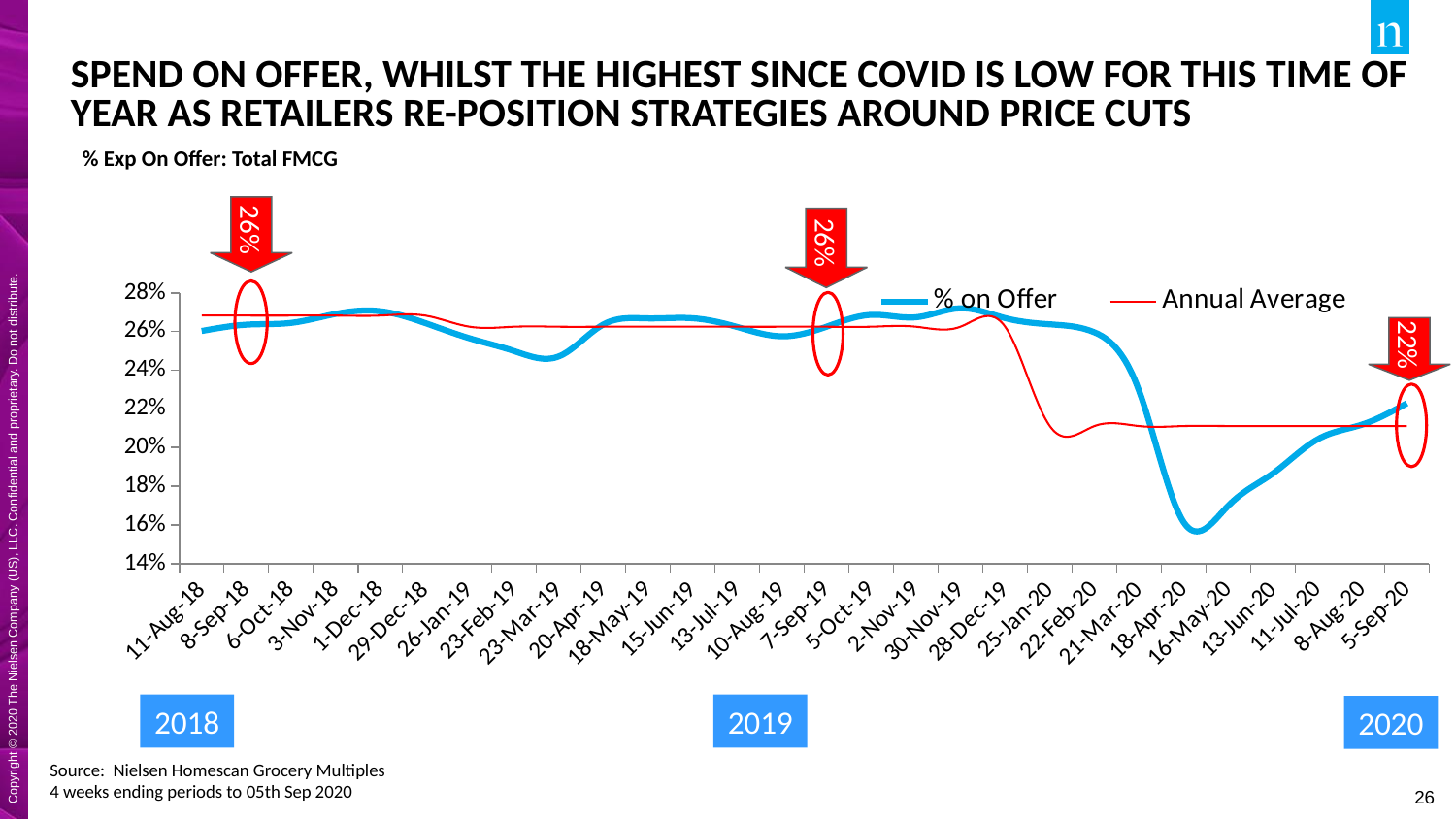
What is the difference between the annotated % on Offer values for 7-Sep-19 and 5-Sep-20? 4 percentage points What is the % on Offer value annotated for 5-Sep-20? 22% What is the % on Offer value annotated for 8-Sep-18? 26% Which is larger, the annotated % on Offer value for 8-Sep-18 or for 5-Sep-20? 8-Sep-18 Is the % on Offer value for 16-May-20 greater or less than 18%? less What is the subtitle printed above the chart? % Exp On Offer: Total FMCG What is the % on Offer value annotated for 7-Sep-19? 26% Does the % on Offer line rise or fall between 28-Dec-19 and 16-May-20? fall How many series does the legend list? 2 Is the % on Offer value for 23-Mar-19 greater or less than 26%? less How many date labels are shown on the x axis? 28 What type of chart is shown on the slide? Line chart